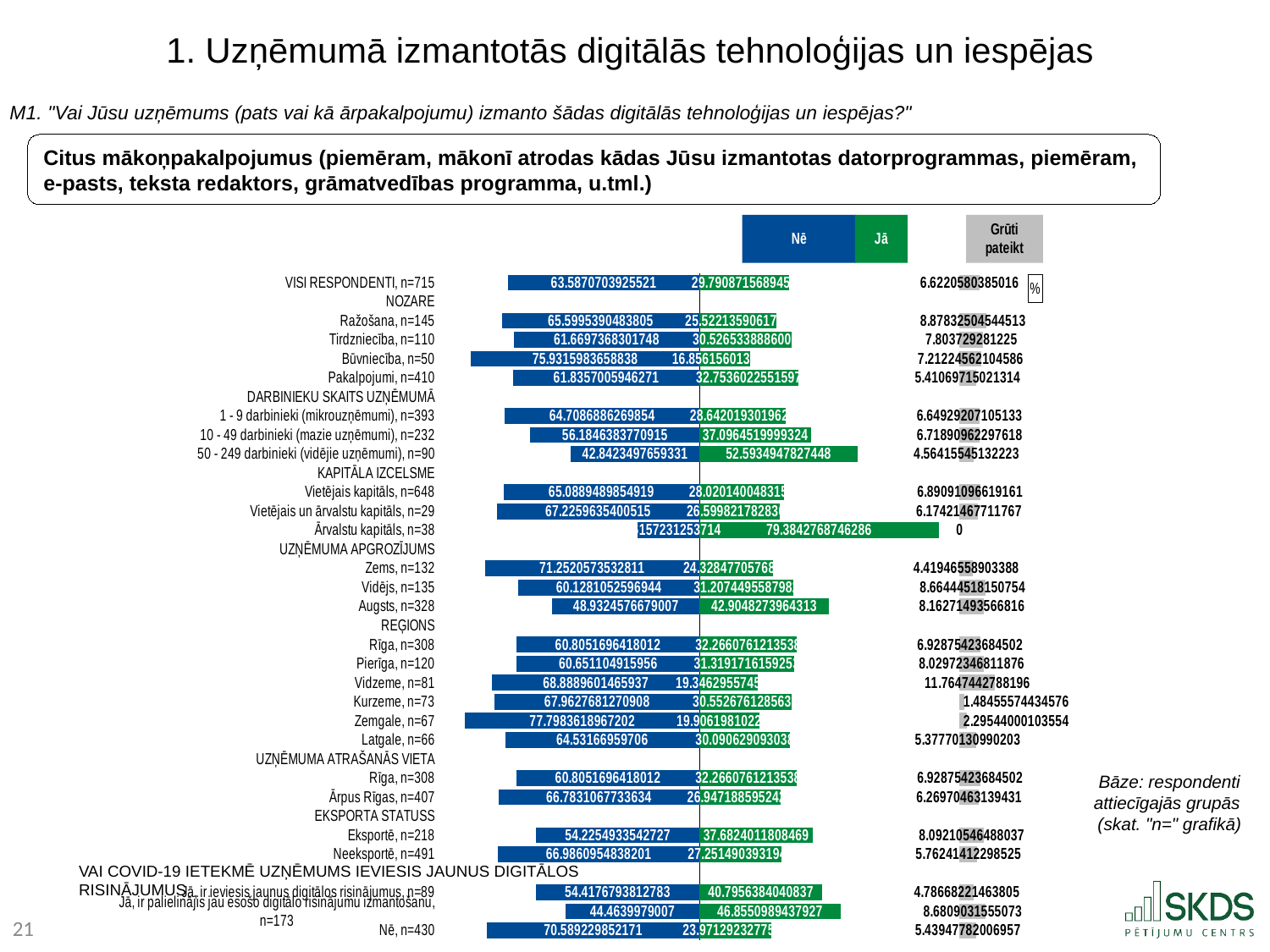
Which group has the highest "Jā" value? Ārvalstu kapitāls, n=38 What is the "Jā" value for Ārvalstu kapitāls, n=38? 79.3842768746286 What is the "Jā" value for 50 - 249 darbinieki (vidējie uzņēmumi), n=90? 52.5934947827448 For Zems, n=132 and Augsts, n=328, which has the larger "Nē" value? Zems, n=132 What kind of chart is shown on the slide? bar chart What is the "Nē" value for Būvniecība, n=50? 75.9315983658838 How many series does the legend list? 3 Which group has the highest "Grūti pateikt" value? Vidzeme, n=81 What are the three legend entries of the chart? Nē, Jā, Grūti pateikt Which group has the lowest "Nē" value? Ārvalstu kapitāls, n=38 What is the "Grūti pateikt" value for Ārvalstu kapitāls, n=38? 0 What is the "Nē" value for VISI RESPONDENTI, n=715? 63.5870703925521